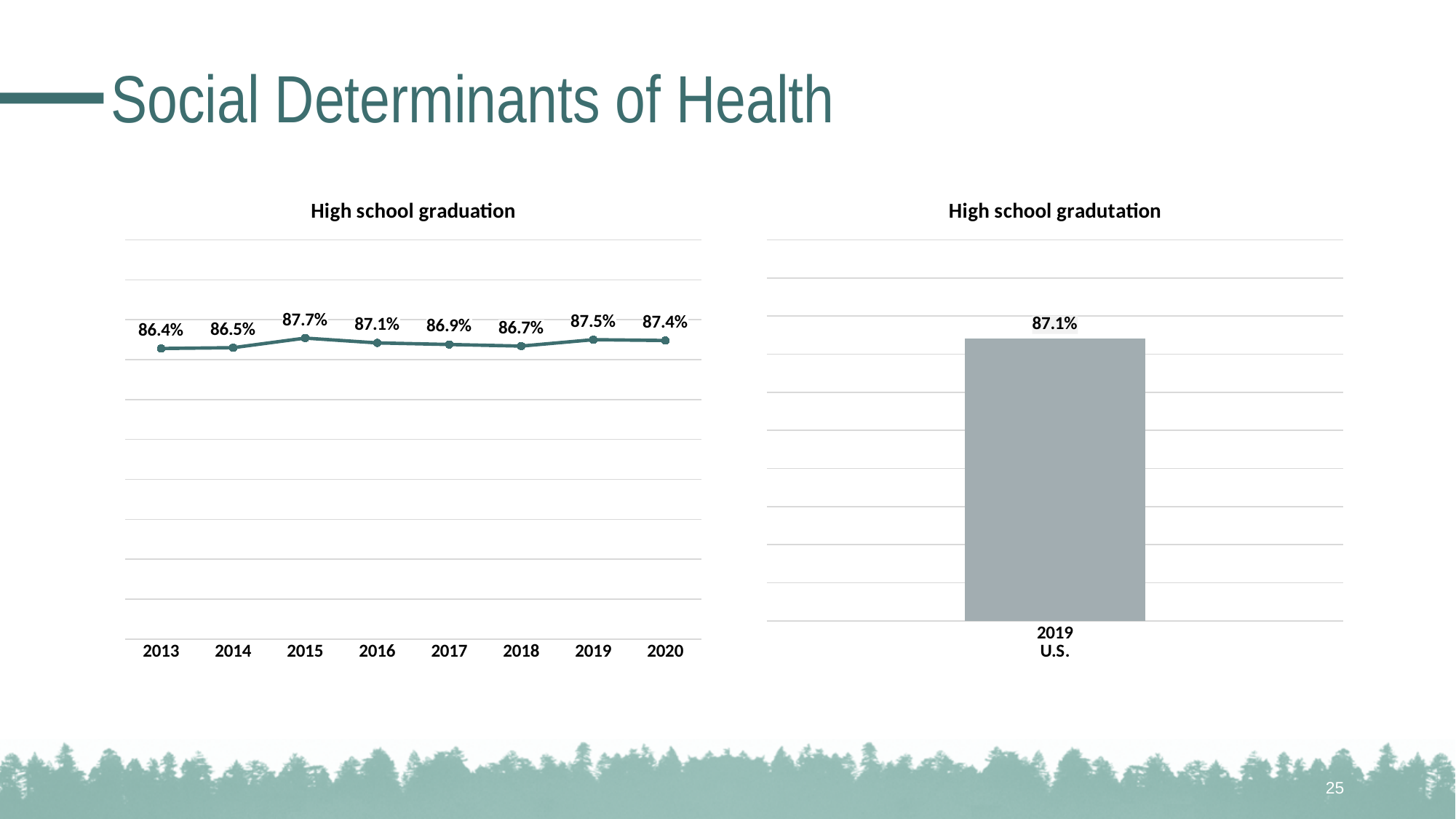
What kind of chart is the right chart titled 'High school gradutation'? Bar chart In the right chart titled 'High school gradutation', what is the value for 2019 U.S.? 87.1% In the left chart titled 'High school graduation', what is the value for 2015? 87.7% In the left chart titled 'High school graduation', which year has the lowest value? 2013 In the right chart titled 'High school gradutation', how many bars are shown? 1 In the left chart titled 'High school graduation', what is the value for 2013? 86.4% In the left chart titled 'High school graduation', what is the difference between the 2015 value and the 2013 value? 1.3% In the left chart titled 'High school graduation', what is the value for 2020? 87.4% In the left chart titled 'High school graduation', which is larger, the value for 2019 or the value for 2018? 2019 In the left chart titled 'High school graduation', how many years are plotted? 8 What kind of chart is the left chart titled 'High school graduation'? Line chart In the left chart titled 'High school graduation', which year has the highest value? 2015